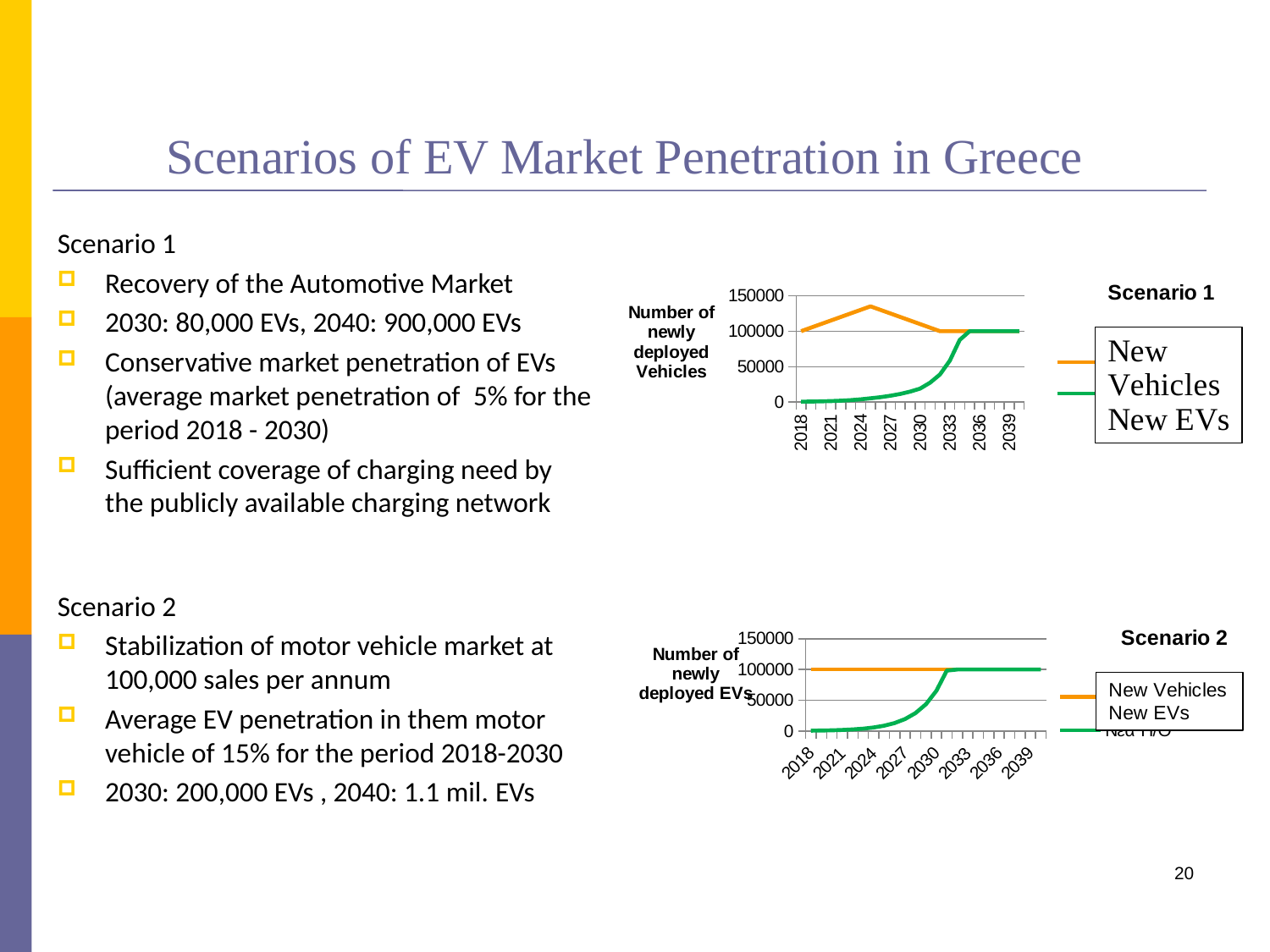
What is the title of the lower chart on the slide? Scenario 2 In the Scenario 2 chart, does the New EVs series rise or fall from 2018 to 2039? rise In the Scenario 2 chart, is the value for New EVs in 2024 greater or less than 50000? less In the Scenario 1 chart, is the value for New EVs in 2021 greater or less than 50000? less What type of chart is the Scenario 1 chart? line chart In the Scenario 1 chart, does the New EVs series rise or fall from 2018 to 2036? rise In the Scenario 1 chart, which series has the larger value in 2024, New Vehicles or New EVs? New Vehicles In the Scenario 1 chart, is the value for New Vehicles in 2024 greater or less than 100000? greater In the Scenario 1 chart, which series is shown in orange? New Vehicles In the Scenario 2 chart, what is the value of New Vehicles in 2018? 100000 How many series does the legend of the Scenario 2 chart list? 2